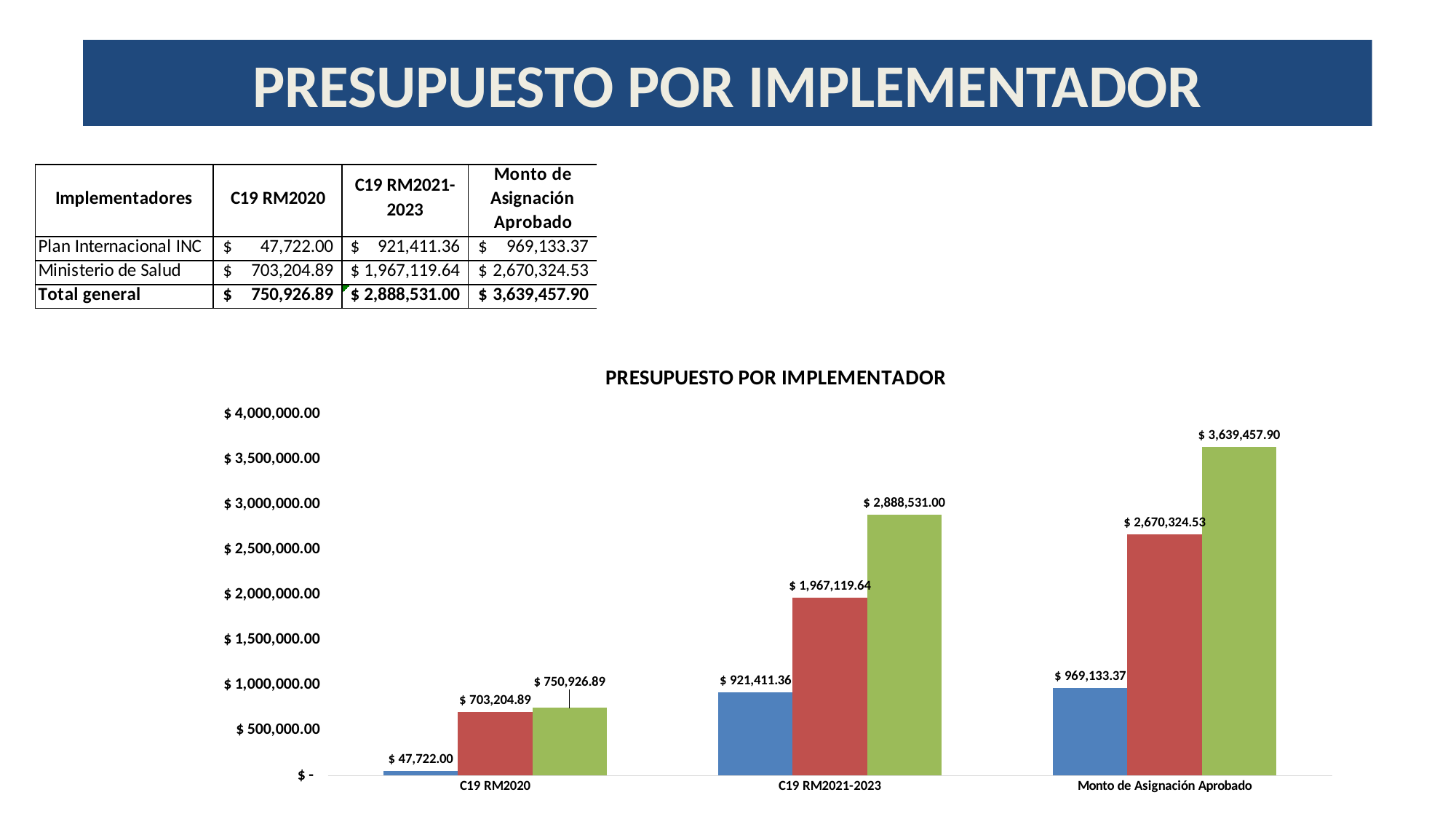
What is the value of the red bar for Monto de Asignación Aprobado? $ 2,670,324.53 What is the value of the blue bar for C19 RM2020? $ 47,722.00 Is the value of the green bar for C19 RM2020 greater or less than $ 1,000,000.00? less Which category has the highest green bar? Monto de Asignación Aprobado Which category has the lowest blue bar? C19 RM2020 How many categories are shown on the x axis of the chart? 3 Is the red bar for C19 RM2021-2023 larger or smaller than the red bar for Monto de Asignación Aprobado? smaller What kind of chart is shown on the slide? bar chart What is the title of the chart? PRESUPUESTO POR IMPLEMENTADOR What is the difference between the green bar and the red bar for Monto de Asignación Aprobado? $ 969,133.37 What is the value of the green bar for C19 RM2021-2023? $ 2,888,531.00 What is the value of the blue bar for C19 RM2021-2023? $ 921,411.36